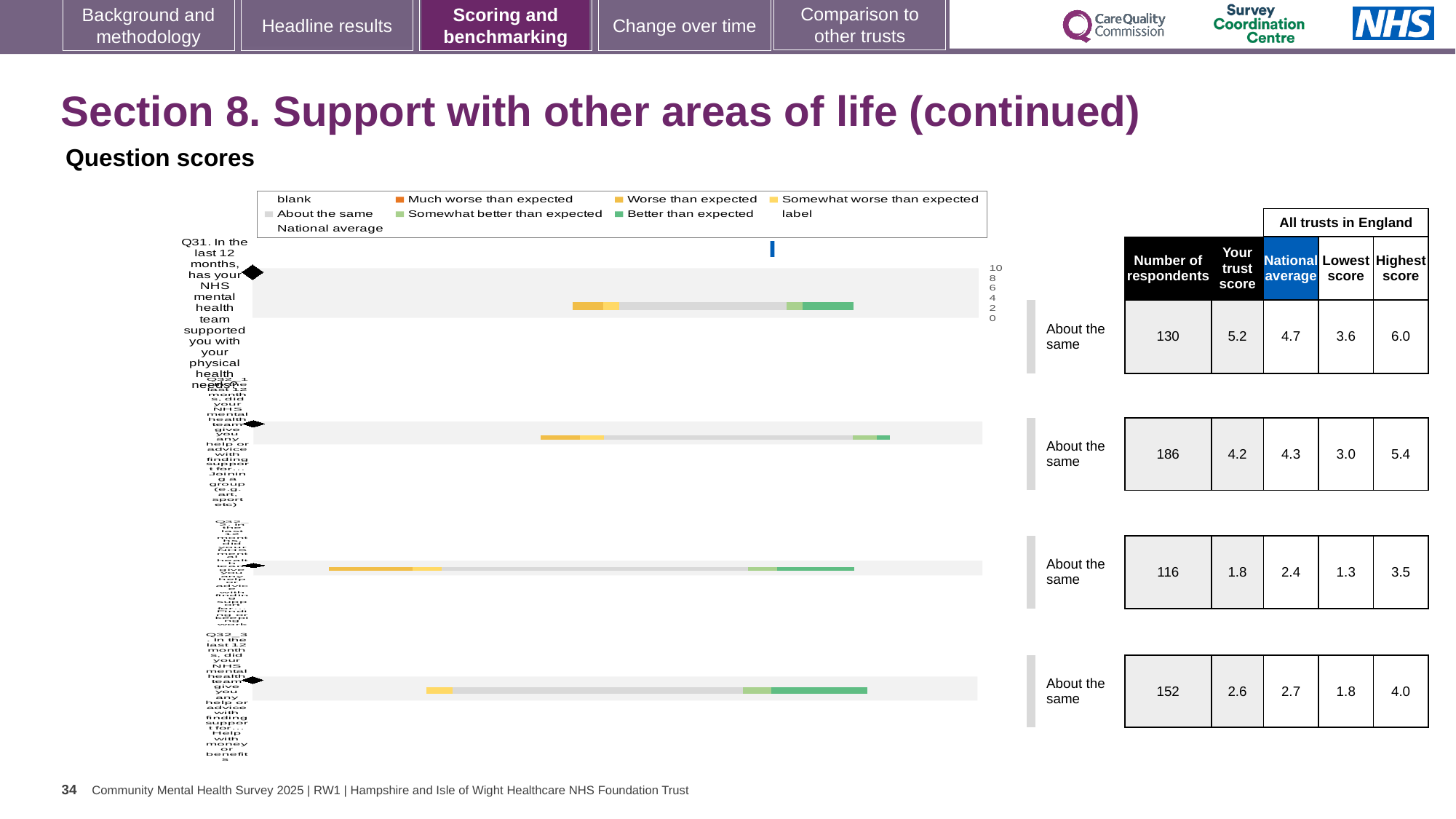
What is the 'Your trust score' for the last row (Q32_3, help with money or benefits)? 2.6 For the first row (Q31), which is larger: the trust score or the national average? Your trust score (5.2) What is the national average shown for the first row (Q31) in the table beside the chart? 4.7 Which row in the table beside the chart has the lowest 'Lowest score' value? The third row (1.3) For the first row (Q31), what is the difference between the highest score (6.0) and the lowest score (3.6)? 2.4 How many question rows (bars) are plotted in the question scores chart? 4 What benchmark category label is shown next to each of the four bars in the chart? About the same What colour represents 'Better than expected' in the chart legend? Green What kind of chart is used to show the question scores on this slide? bar chart How many respondents are listed for the first row (Q31) in the table beside the chart? 130 Which row in the table beside the chart has the highest number of respondents? The second row (186) In the table beside the chart, what is the 'Your trust score' for the first row (Q31, support with physical health needs)? 5.2